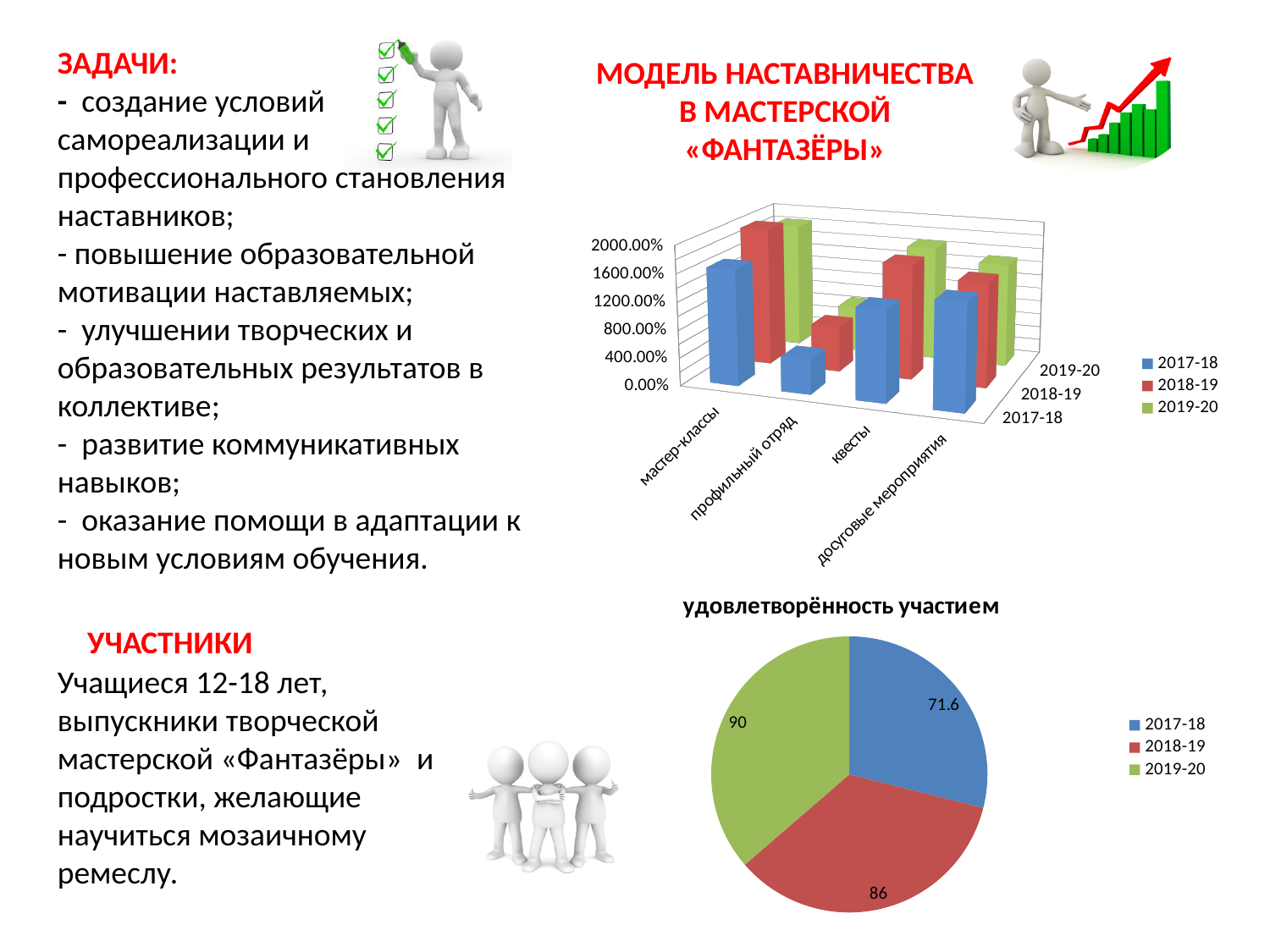
What type of chart is the chart titled 'удовлетворённость участием'? pie chart In the pie chart 'удовлетворённость участием', what is the value for 2017-18? 71.6 In the bar chart in the upper right of the slide, how many categories are shown on the x axis? 4 What type of chart is the chart in the upper right of the slide? bar chart In the pie chart 'удовлетворённость участием', what is the difference between the values for 2019-20 and 2017-18? 18.4 In the bar chart in the upper right of the slide, is the 2017-18 value for 'профильный отряд' greater or less than 800.00%? less In the pie chart 'удовлетворённость участием', which year has the smallest slice? 2017-18 In the pie chart 'удовлетворённость участием', which year has the largest slice? 2019-20 In the pie chart 'удовлетворённость участием', how many slices are there? 3 In the pie chart 'удовлетворённость участием', what is the value for 2018-19? 86 In the pie chart 'удовлетворённость участием', what is the value for 2019-20? 90 In the bar chart in the upper right of the slide, how many series does the legend list? 3